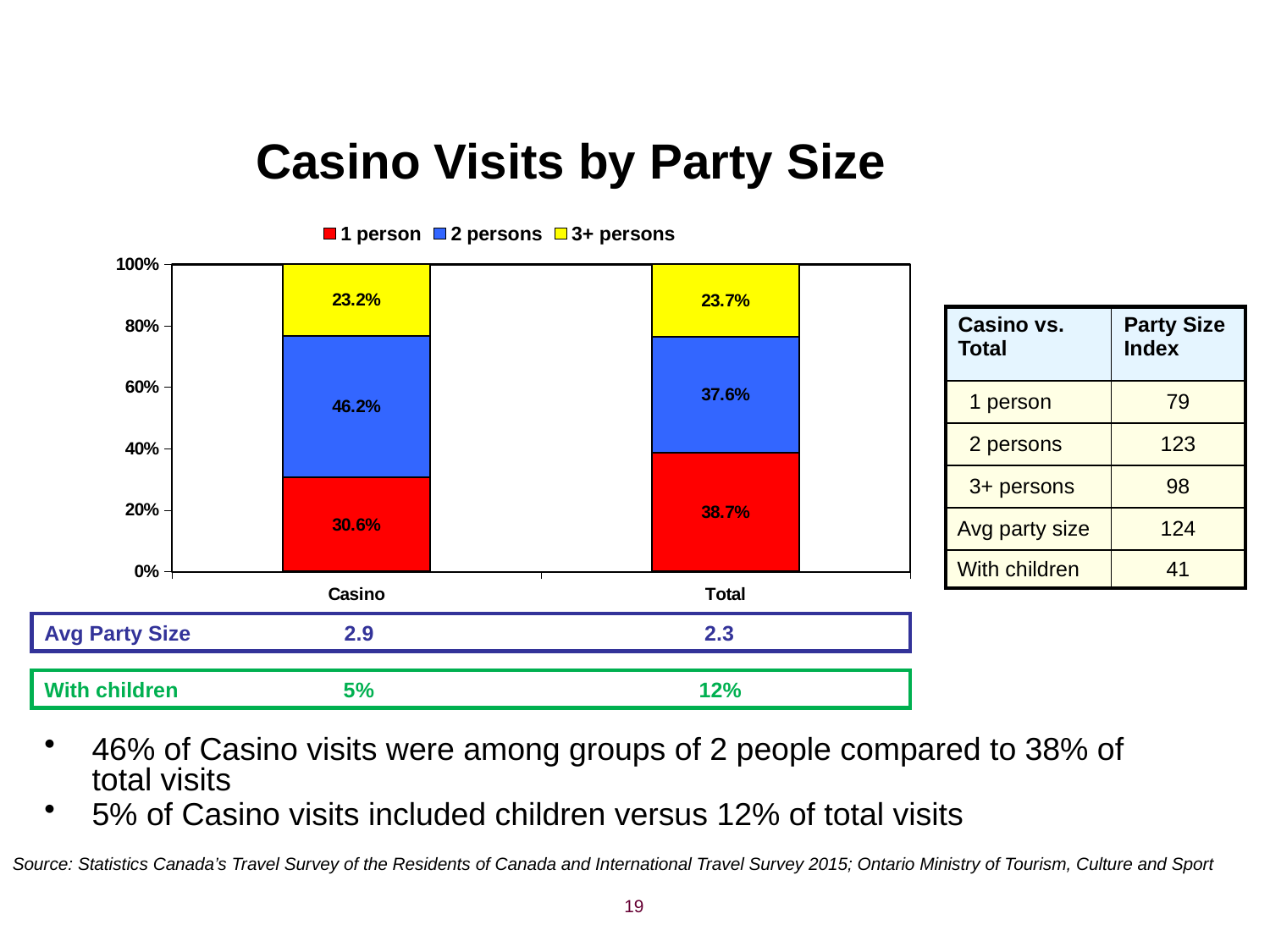
What percentage of Total visits were by 2 persons? 37.6% What kind of chart is shown? Stacked bar chart What percentage of Casino visits were by 3+ persons? 23.2% Which party size has the largest share of Casino visits? 2 persons What colour represents the 2 persons series? Blue Which party size has the smallest share of Total visits? 3+ persons What percentage of Total visits were by 1 person? 38.7% What is the difference between the 2 persons share for Casino and for Total? 8.6% How many series does the legend list? 3 How many categories are shown on the x axis? 2 What percentage of Casino visits were by 1 person? 30.6% Which is larger, the 1 person share for Casino or for Total? Total